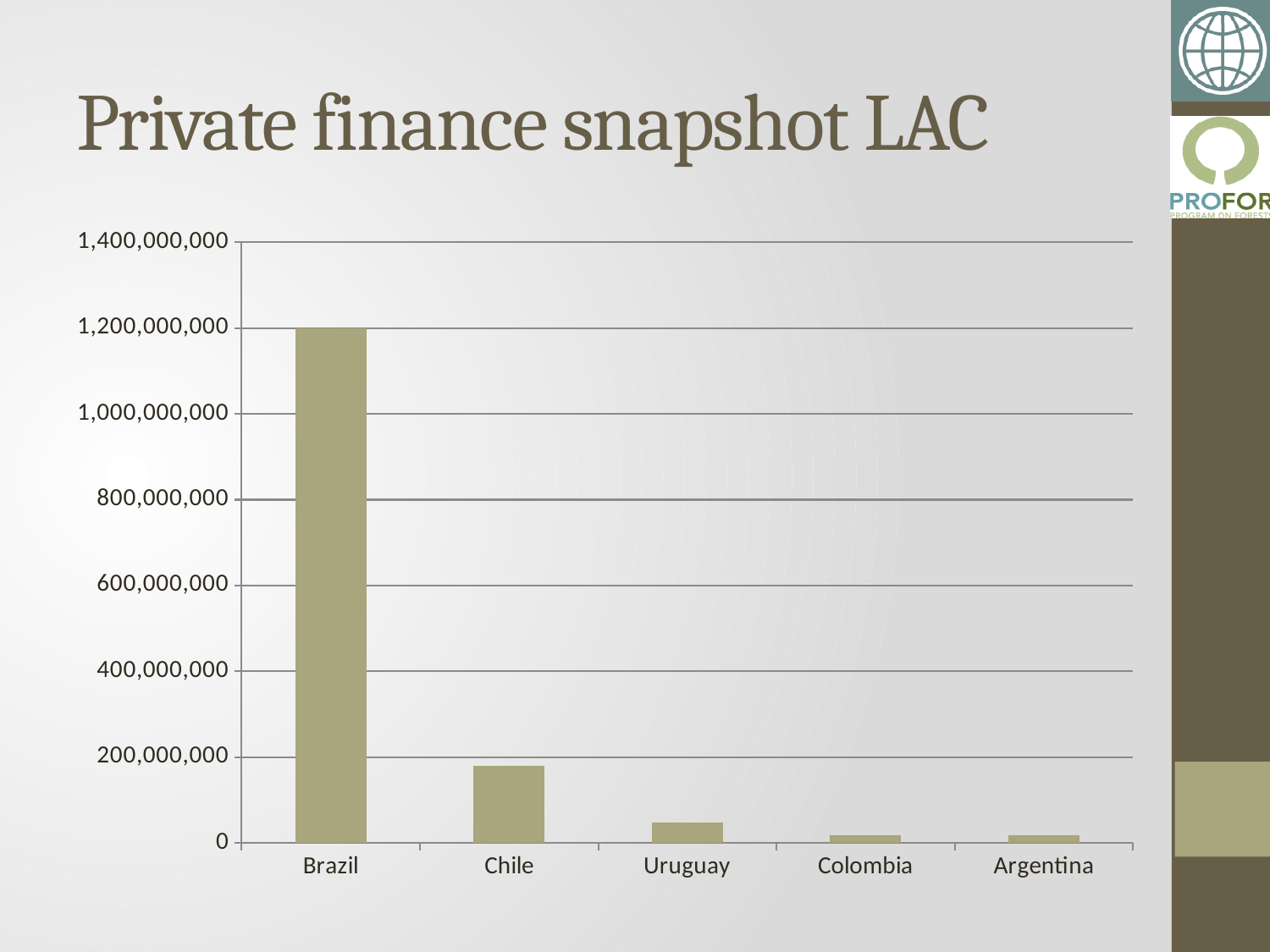
Is the value for Brazil greater or less than 1,000,000,000? greater What is the highest value labelled on the y axis of the chart? 1,400,000,000 What is the title of the chart on the slide? Private finance snapshot LAC Do the values generally rise or fall moving from Brazil to Argentina along the x axis? fall What kind of chart is shown on the slide? bar chart Which has the larger value, Chile or Uruguay? Chile Which country has the highest value in the chart? Brazil Is the value for Chile greater or less than 200,000,000? less Which has the larger value, Brazil or Chile? Brazil Is the value for Uruguay greater or less than 200,000,000? less How many countries are shown on the x axis of the chart? 5 What is the value for Brazil in the chart? 1,200,000,000